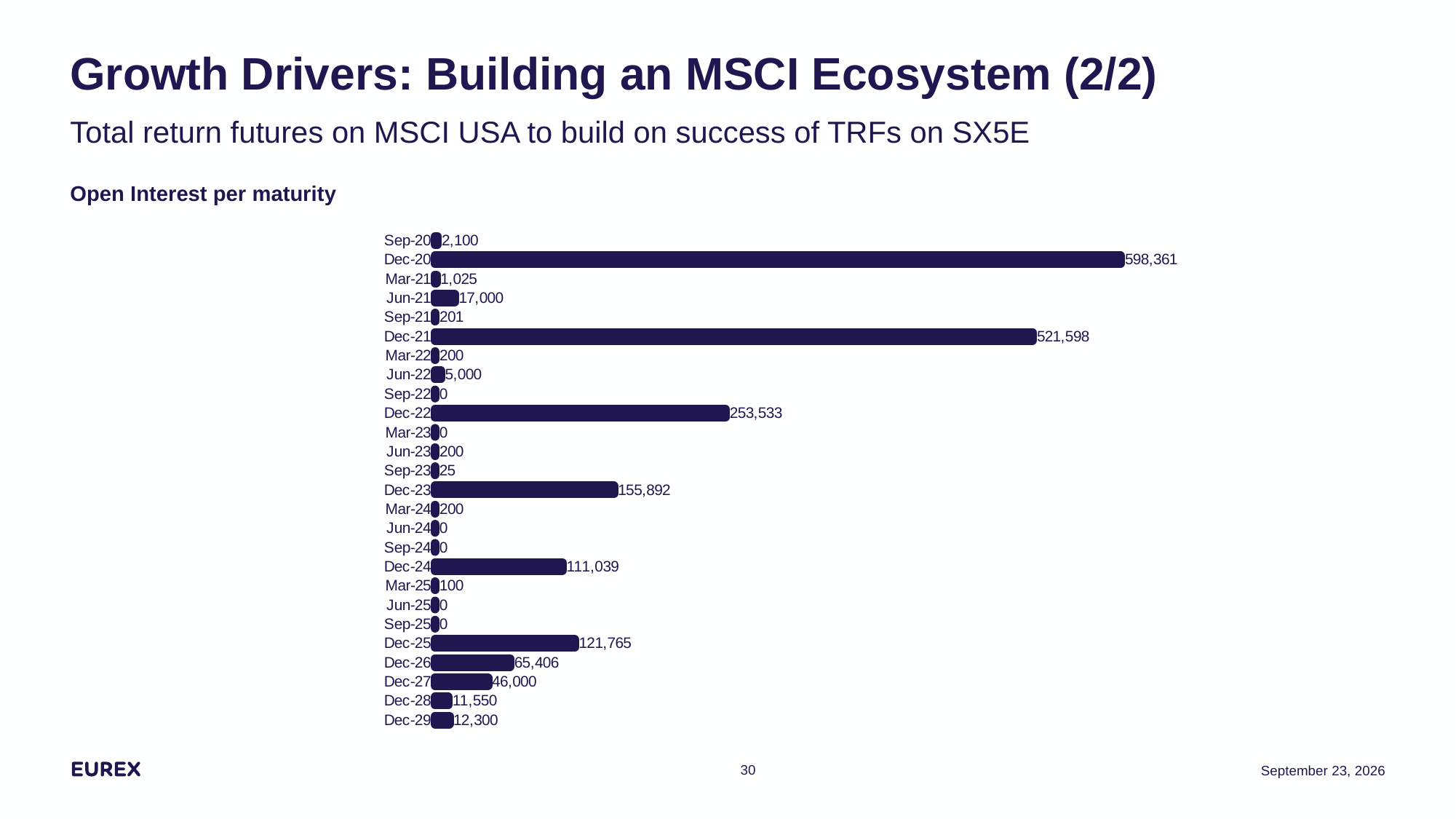
What is the difference in open interest between Dec-20 and Dec-21? 76,763 What is the open interest for the Dec-20 maturity? 598,361 What type of chart is used to show open interest per maturity? Bar chart Which has higher open interest, Dec-28 or Dec-29? Dec-29 What is the title of the chart? Open Interest per maturity What is the open interest for the Dec-22 maturity? 253,533 What is the open interest for the Jun-21 maturity? 17,000 Which has higher open interest, Dec-24 or Dec-25? Dec-25 What is the open interest for the Dec-27 maturity? 46,000 How many maturities are shown in the chart? 26 What is the difference in open interest between Dec-22 and Dec-23? 97,641 Which maturity has the highest open interest? Dec-20